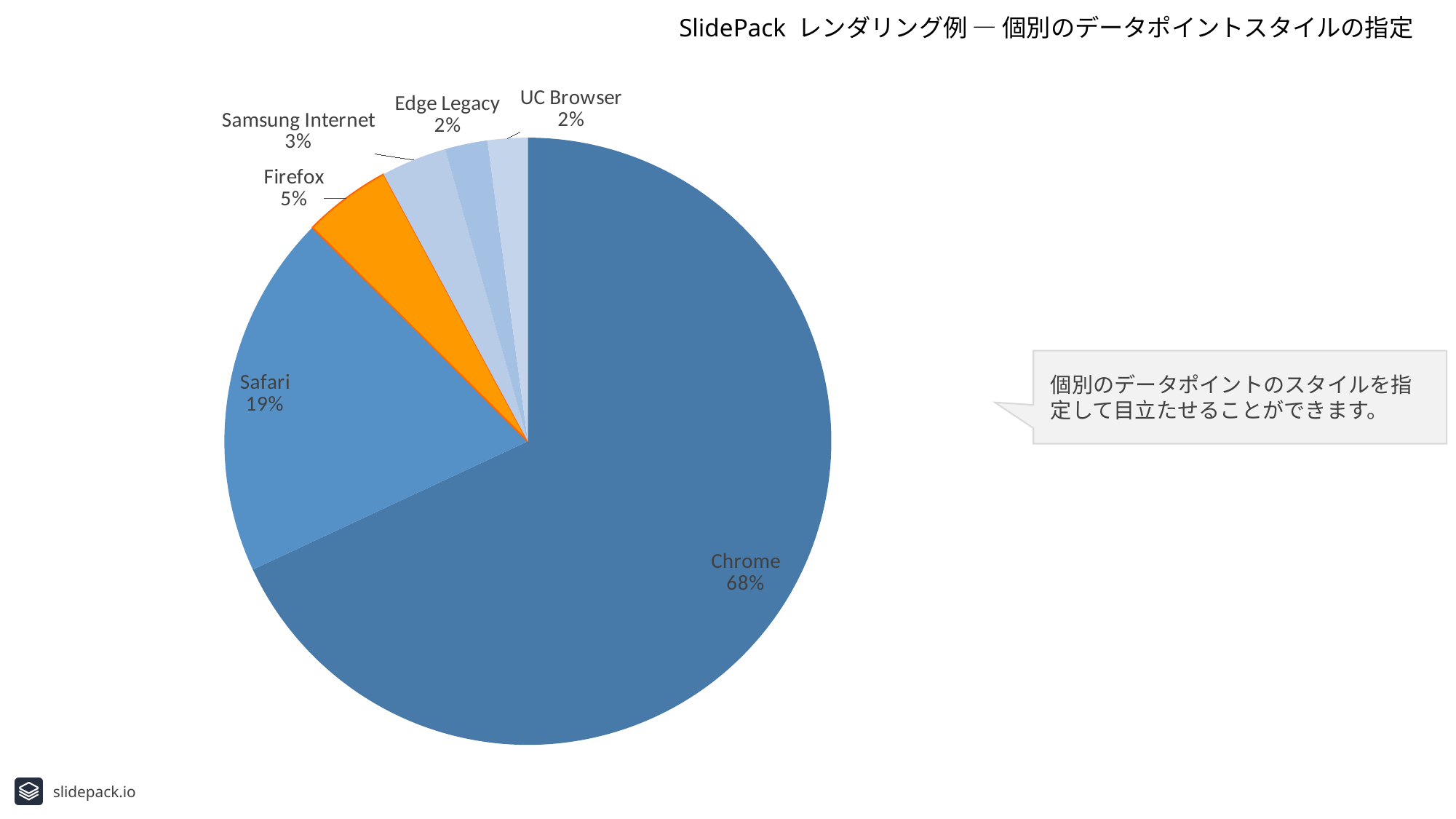
What is the value shown for Safari? 19% What share of the pie does Chrome have? 68% What is the difference between the Safari and Firefox shares? 14% What kind of chart is shown on the slide? Pie chart How many categories are shown in the pie chart? 6 Which is larger, the Firefox slice or the Samsung Internet slice? Firefox What is the difference between the Chrome and Safari shares? 49% What is the value shown for Samsung Internet? 3% Which slice of the pie is coloured orange? Firefox What is the value shown for Firefox? 5% Which category has the largest slice of the pie? Chrome What value is shown for Edge Legacy? 2%